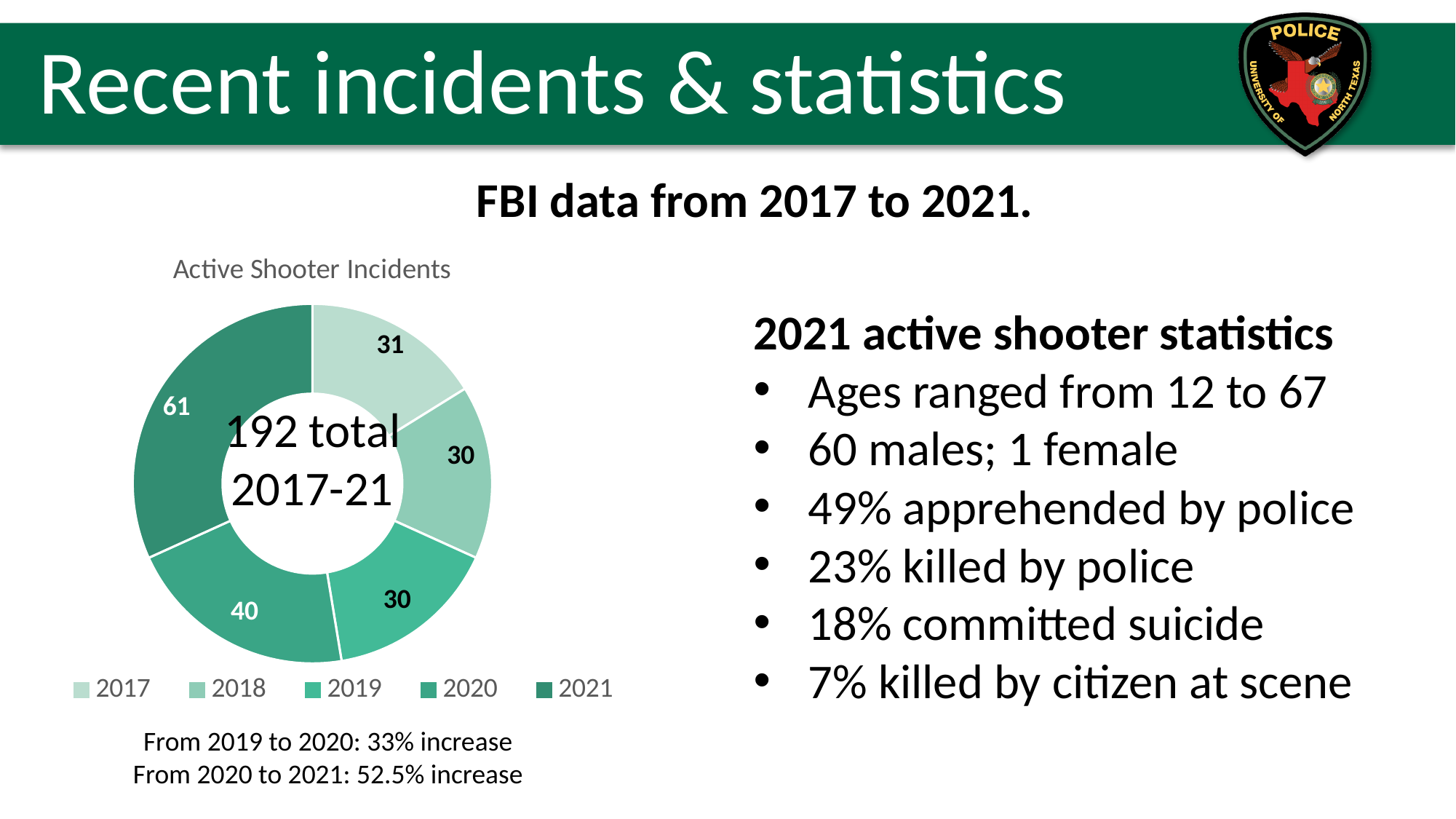
What is the value for 2020 in the Active Shooter Incidents chart? 40 What is the value for 2021 in the Active Shooter Incidents chart? 61 What text is shown in the centre of the doughnut chart? 192 total 2017-21 Which year has the highest number of active shooter incidents in the chart? 2021 What kind of chart is the Active Shooter Incidents chart? Doughnut chart How many years (categories) are shown in the Active Shooter Incidents chart? 5 What is the value for 2017 in the Active Shooter Incidents chart? 31 What is the total of all values shown in the Active Shooter Incidents chart? 192 What is the difference between the 2020 and 2019 values in the Active Shooter Incidents chart? 10 Which is larger in the Active Shooter Incidents chart, the value for 2017 or the value for 2020? 2020 What is the title of the chart on the slide? Active Shooter Incidents What is the difference between the 2021 and 2020 values in the Active Shooter Incidents chart? 21